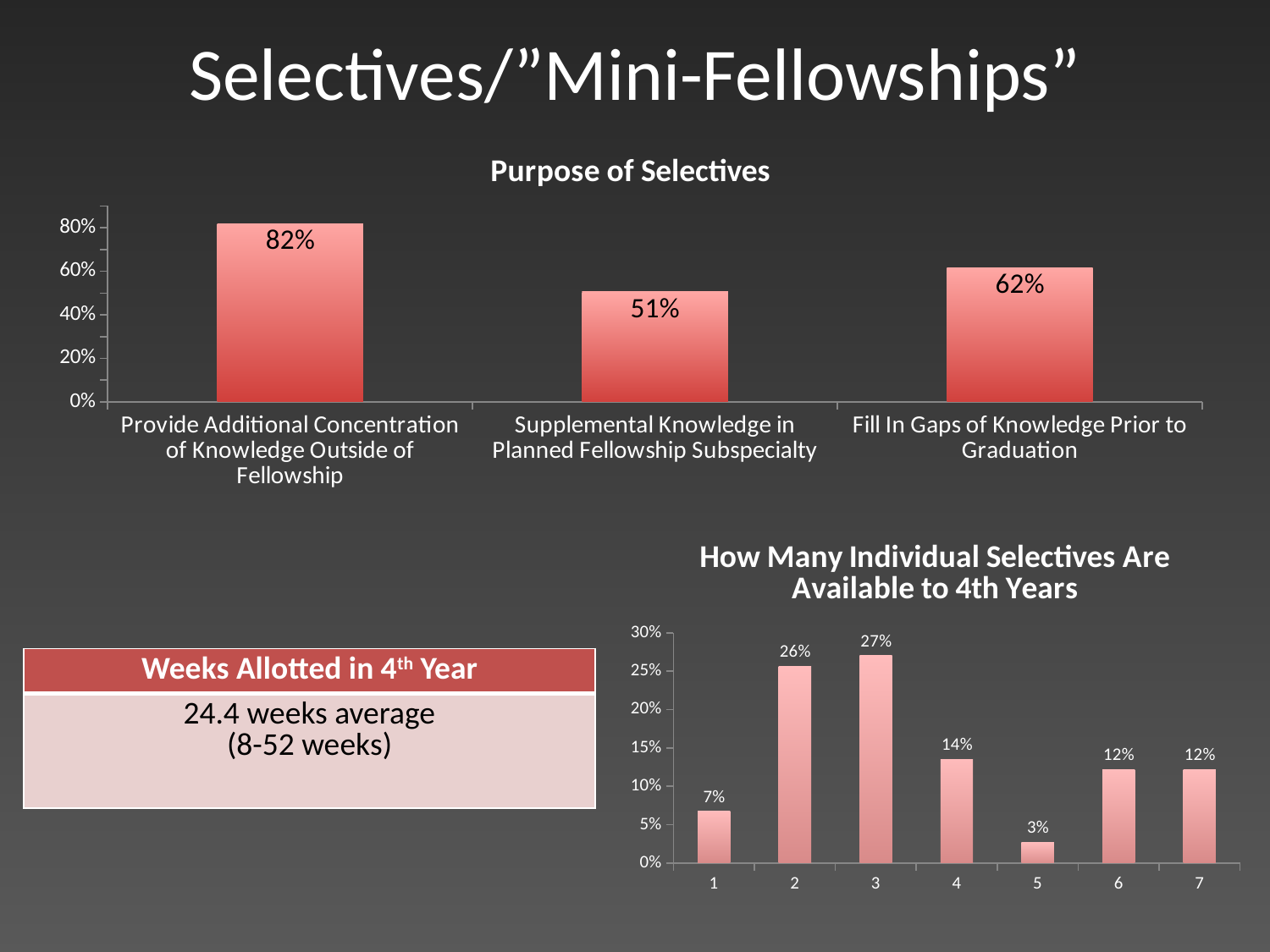
In the 'How Many Individual Selectives Are Available to 4th Years' chart, which category has the highest value? 3 In the 'How Many Individual Selectives Are Available to 4th Years' chart, what is the value for category 5? 3% In the 'Purpose of Selectives' chart, which category has the lowest value? Supplemental Knowledge in Planned Fellowship Subspecialty In the 'How Many Individual Selectives Are Available to 4th Years' chart, how many categories are shown on the x axis? 7 In the 'How Many Individual Selectives Are Available to 4th Years' chart, what is the difference between the values for category 2 and category 1? 19% In the 'Purpose of Selectives' chart, what is the difference between 'Provide Additional Concentration of Knowledge Outside of Fellowship' and 'Fill In Gaps of Knowledge Prior to Graduation'? 20% In the 'Purpose of Selectives' chart, what is the value for 'Provide Additional Concentration of Knowledge Outside of Fellowship'? 82% In the 'Purpose of Selectives' chart, how many categories are shown? 3 In the 'How Many Individual Selectives Are Available to 4th Years' chart, what is the value for category 3? 27% What kind of chart is the 'How Many Individual Selectives Are Available to 4th Years' chart? Bar chart In the 'Purpose of Selectives' chart, what is the value for 'Supplemental Knowledge in Planned Fellowship Subspecialty'? 51% In the 'How Many Individual Selectives Are Available to 4th Years' chart, which is larger, the value for category 1 or category 4? 4